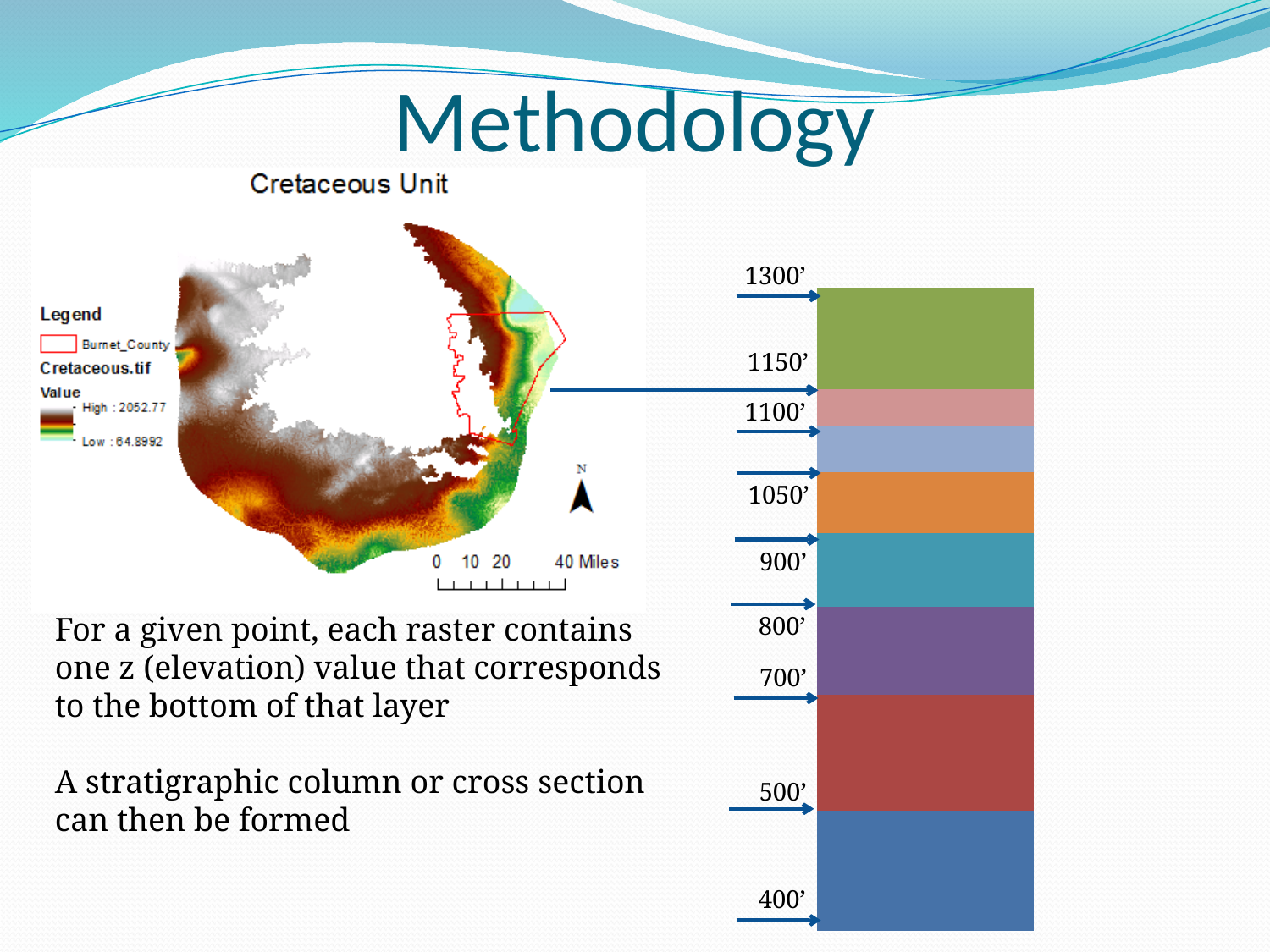
What is the largest distance marked on the map's scale bar? 40 Miles What is the title of the map on the left of the slide? Cretaceous Unit What colour is the topmost layer of the stratigraphic column? green Do the elevation labels on the stratigraphic column increase or decrease from top to bottom? decrease How many coloured layers are shown in the stratigraphic column on the right? 8 What is the difference between the top elevation label (1300') and the bottom elevation label (400') on the stratigraphic column? 900' What is the highest elevation label shown on the stratigraphic column on the right? 1300' In the map legend, what is the High value for Cretaceous.tif? 2052.77 How many elevation labels are printed beside the stratigraphic column? 9 What is the lowest elevation label shown on the stratigraphic column on the right? 400' In the map legend, what is the Low value for Cretaceous.tif? 64.8992 Which is larger, the elevation label 1150' or the elevation label 1050' on the stratigraphic column? 1150'